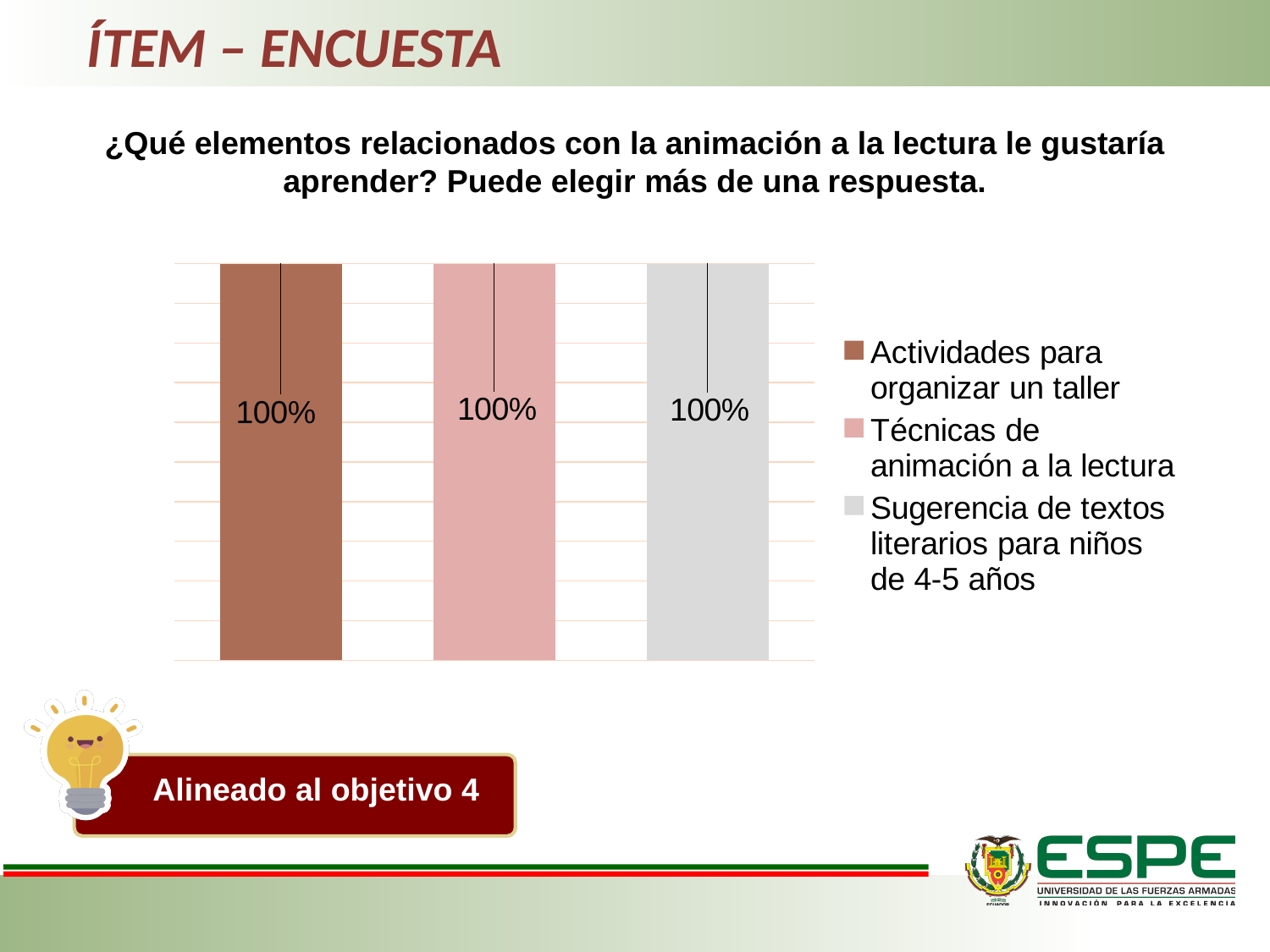
What value is shown for "Técnicas de animación a la lectura"? 100% What is the difference between the value for "Actividades para organizar un taller" and the value for "Técnicas de animación a la lectura"? 0% What value is shown for "Actividades para organizar un taller"? 100% What value is shown for "Sugerencia de textos literarios para niños de 4-5 años"? 100% How many bars are plotted in the chart? 3 Do the values rise, fall, or stay the same across the three bars from left to right? Stay the same How many entries does the legend list? 3 What kind of chart is shown on the slide? Bar chart Is the value for "Sugerencia de textos literarios para niños de 4-5 años" larger than, smaller than, or equal to the value for "Actividades para organizar un taller"? Equal Which legend entry is represented by the brown bar? Actividades para organizar un taller Which legend entry is represented by the grey bar? Sugerencia de textos literarios para niños de 4-5 años